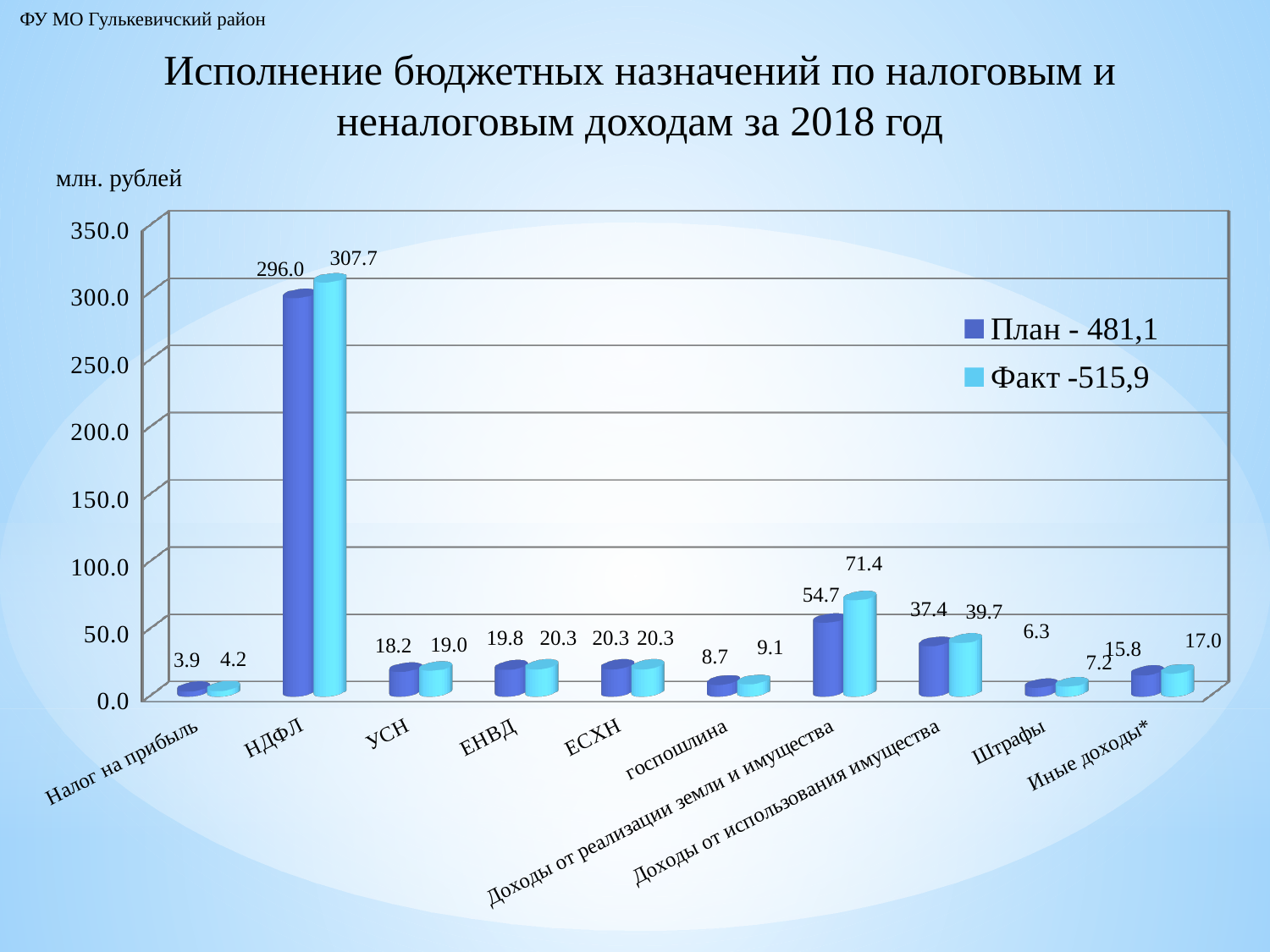
What is the difference between the Факт and План values for НДФЛ? 11.7 How many series does the legend list? 2 Which category has the lowest План value? Налог на прибыль What kind of chart is shown on the slide? Bar chart What is the difference between the Факт and План values for Доходы от реализации земли и имущества? 16.7 Which is larger, the План value for УСН or the План value for ЕНВД? ЕНВД How many categories are shown on the x axis? 10 What is the Факт value for Доходы от реализации земли и имущества? 71.4 What is the План value for НДФЛ? 296.0 What unit is indicated above the chart? млн. рублей What is the Факт value for Штрафы? 7.2 Which category has the highest Факт value? НДФЛ